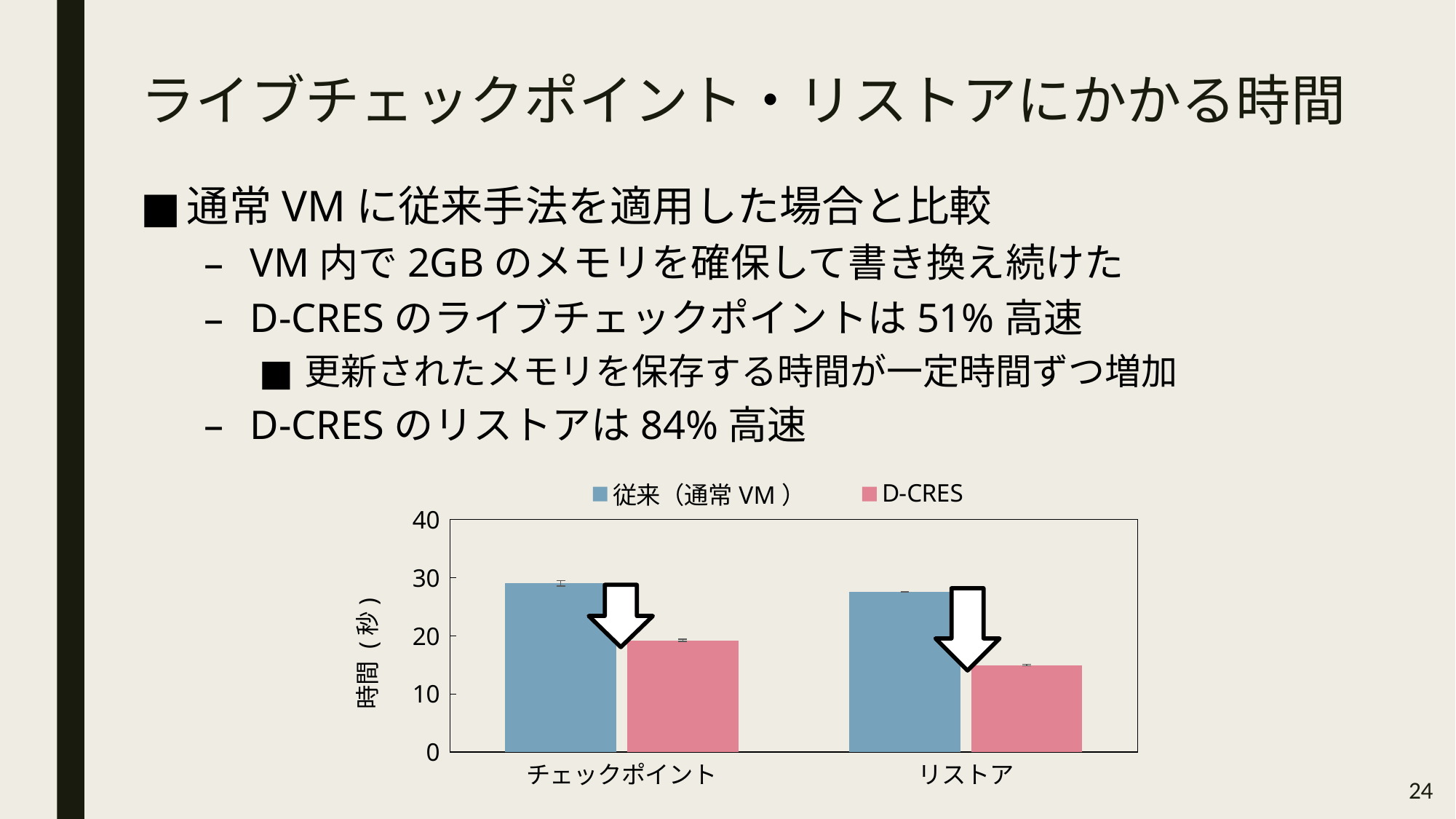
Which bar in the chart is the lowest? D-CRES for リストア What is the label of the chart's vertical axis? 時間（秒） Is the D-CRES value for リストア greater or less than 20? less Is the 従来（通常 VM） value for チェックポイント greater or less than 20? greater What are the two series listed in the chart's legend? 従来（通常 VM）, D-CRES Is the 従来（通常 VM） value for リストア greater or less than 30? less For リストア, which series has the larger value, 従来（通常 VM） or D-CRES? 従来（通常 VM） What kind of chart is shown on the slide? bar chart How many series does the chart's legend list? 2 For チェックポイント, which series has the larger value, 従来（通常 VM） or D-CRES? 従来（通常 VM） How many categories are shown on the x axis of the chart? 2